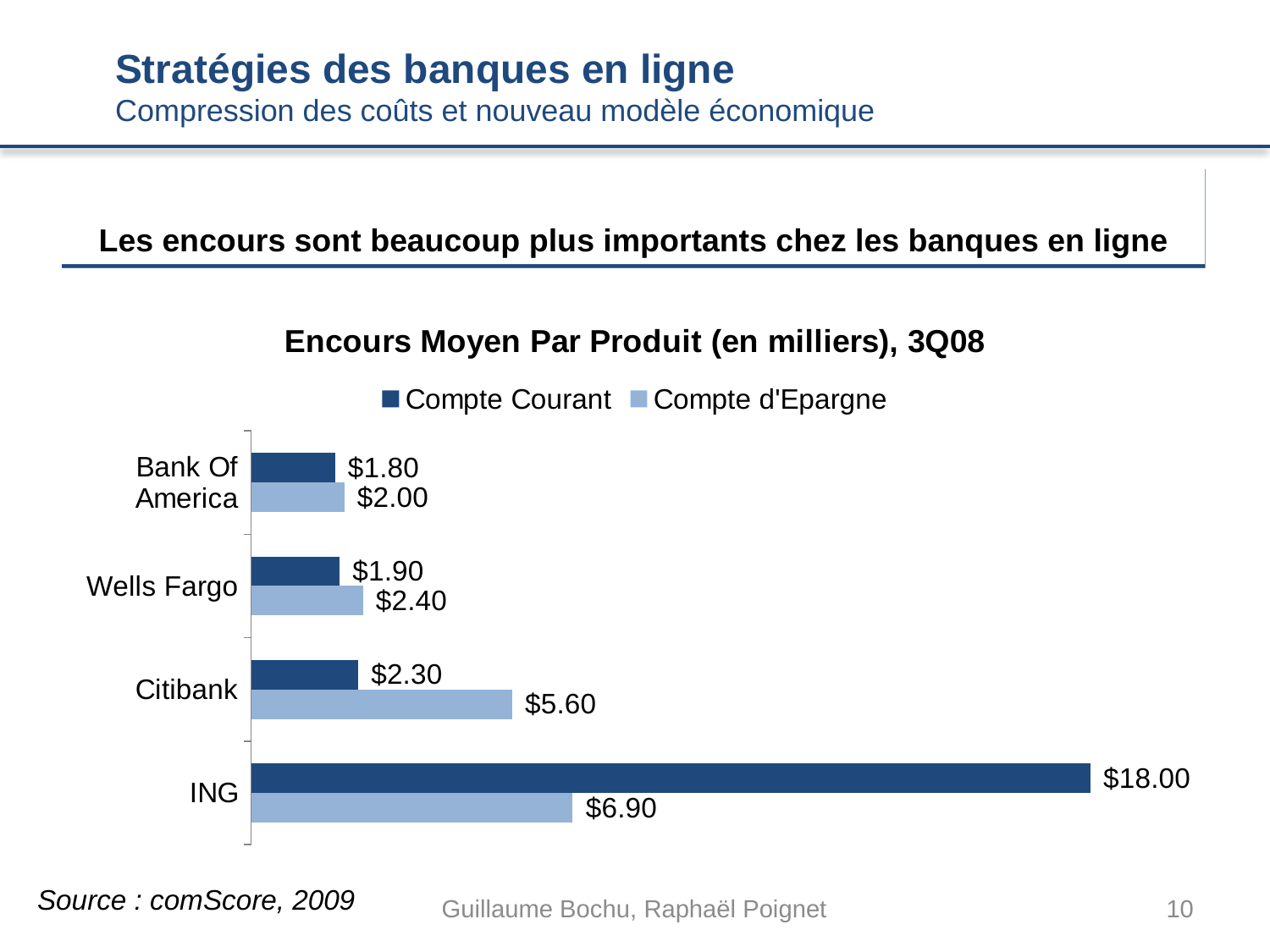
What is the difference between the Compte Courant and Compte d'Epargne values for ING? $11.10 Which is larger for Citibank, the Compte Courant value or the Compte d'Epargne value? Compte d'Epargne How many series does the legend list? 2 Which bank has the lowest Compte d'Epargne value? Bank Of America What is the Compte d'Epargne value for Bank Of America? $2.00 Which bank has the highest Compte Courant value? ING What is the title of the chart? Encours Moyen Par Produit (en milliers), 3Q08 How many banks are shown in the chart? 4 What is the Compte Courant value for ING? $18.00 What kind of chart is shown on the slide? Bar chart What is the Compte Courant value for Wells Fargo? $1.90 What is the Compte d'Epargne value for Citibank? $5.60